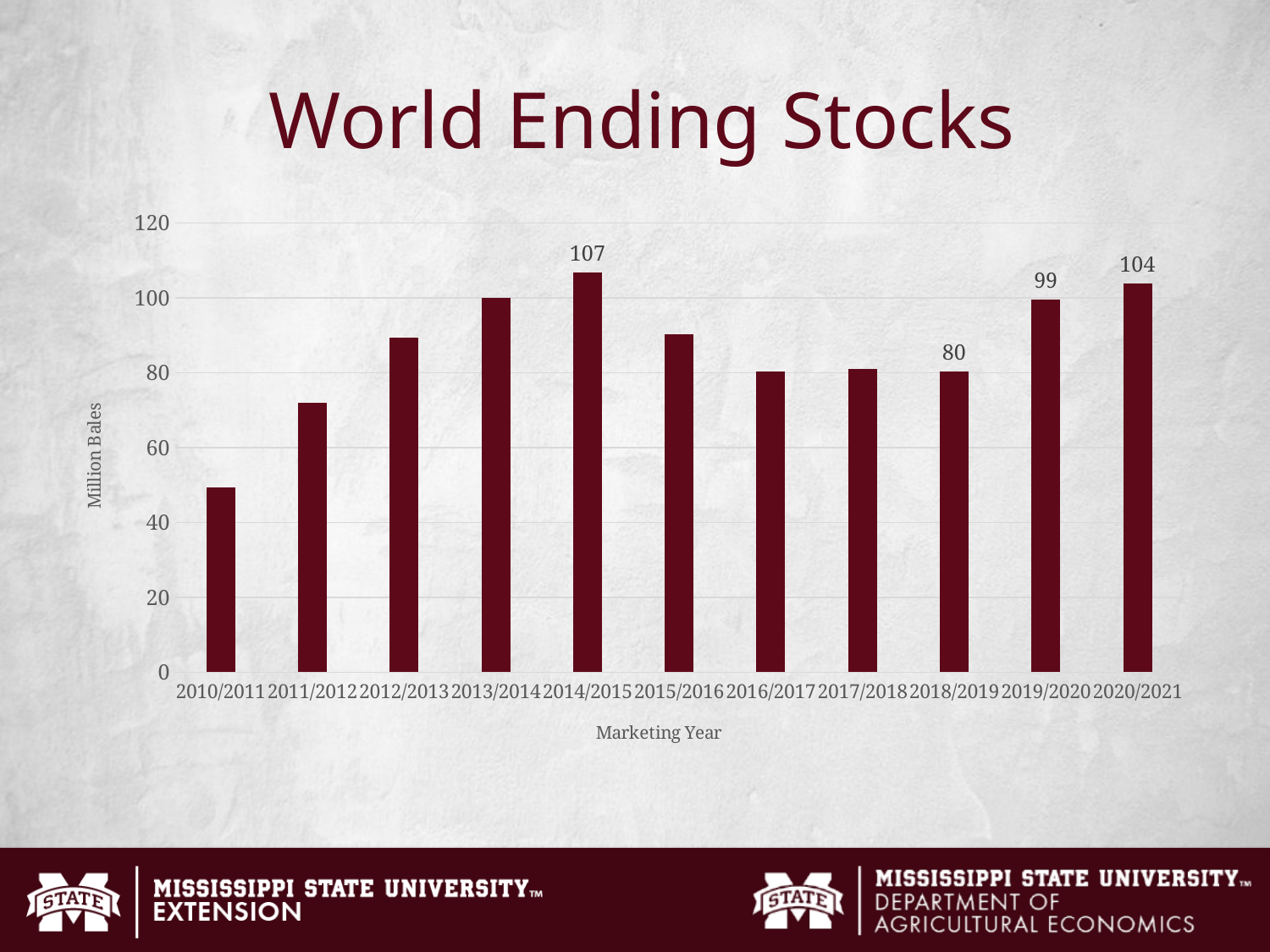
Which is larger, the value for 2019/2020 or the value for 2020/2021? 2020/2021 What is the value for 2014/2015? 107 Which marketing year has the highest world ending stocks? 2014/2015 What is the value for 2018/2019? 80 Is the value for 2010/2011 greater or less than 60? less What is the label on the vertical axis? Million Bales What kind of chart is this? bar chart What is the difference between the values for 2014/2015 and 2018/2019? 27 Which marketing year has the lowest world ending stocks? 2010/2011 How many marketing years are shown on the x axis? 11 What is the value for 2020/2021? 104 Is the value for 2012/2013 greater or less than 100? less